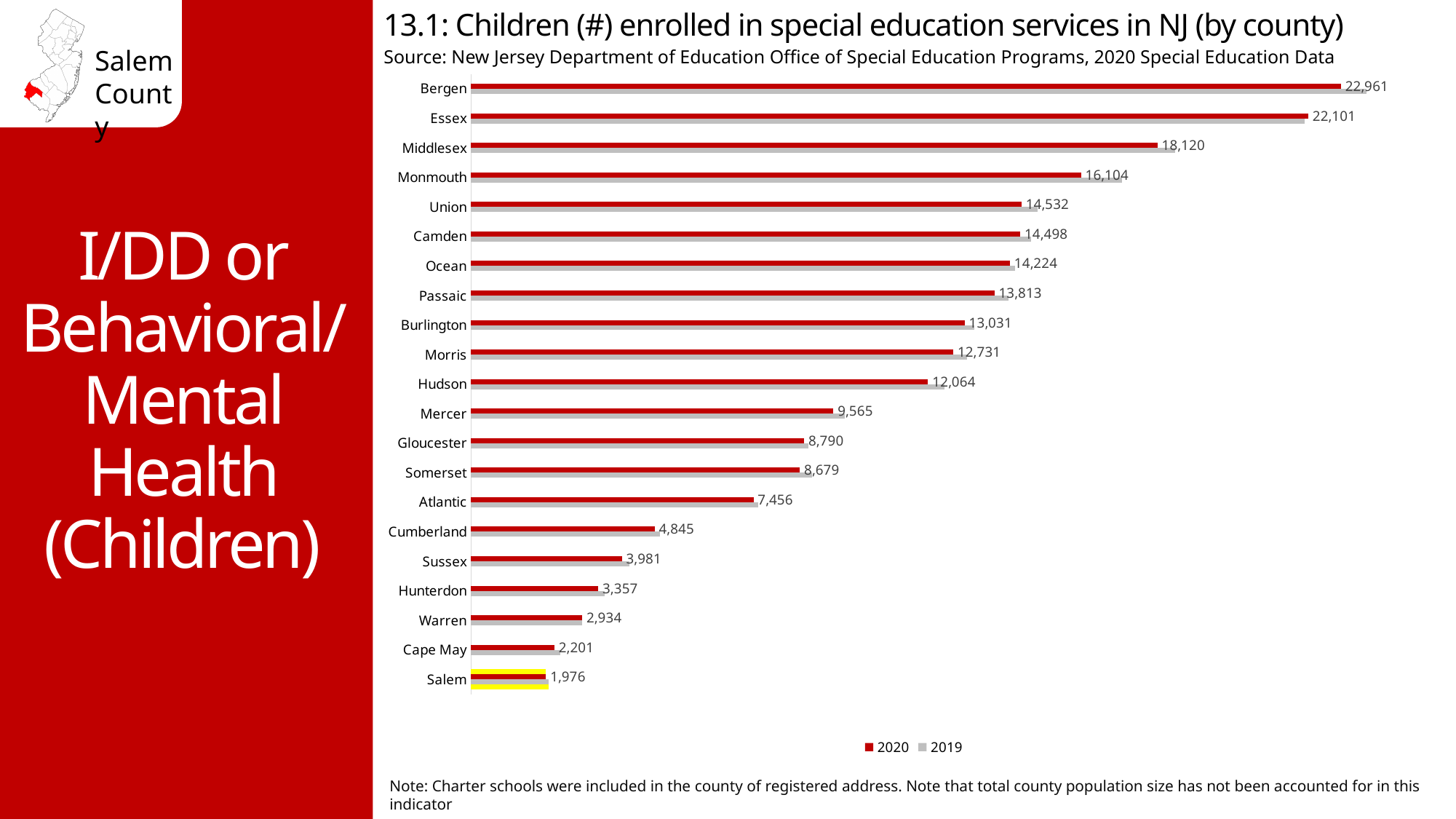
What is the 2020 value for Salem? 1,976 Which county has the lowest 2020 value? Salem What is the 2020 value for Cumberland? 4,845 Which has a larger 2020 value, Mercer or Atlantic? Mercer What is the 2020 value for Middlesex? 18,120 What is the difference between the 2020 values for Cape May and Salem? 225 What is the difference between the 2020 values for Bergen and Essex? 860 What type of chart is shown on the slide? bar chart How many series does the legend list? 2 Which county has the highest 2020 value? Bergen Which colour represents the 2020 series in the chart? red How many counties are shown in the chart? 21